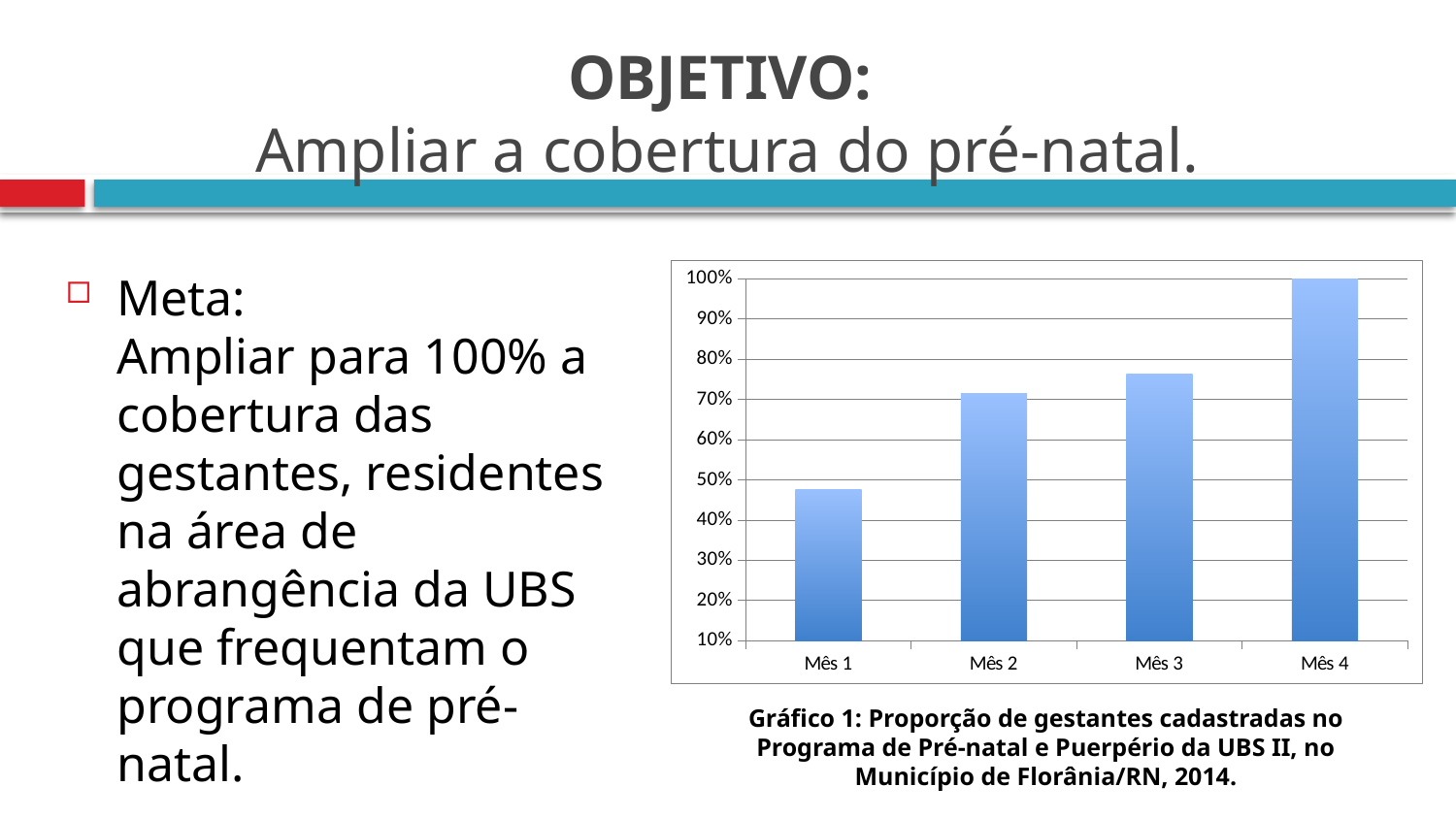
Do the values rise or fall from Mês 1 to Mês 4? rise Is the value for Mês 3 greater or less than 90%? less Is the value for Mês 1 greater or less than 60%? less Which month has the highest value? Mês 4 What is the value for Mês 4? 100% Is the value for Mês 2 greater or less than 60%? greater What kind of chart is shown on the slide? bar chart Which is larger, the value for Mês 2 or the value for Mês 3? Mês 3 What is the lowest percentage shown on the vertical axis of the chart? 10% Which month has the lowest value? Mês 1 How many months (categories) are plotted in the chart? 4